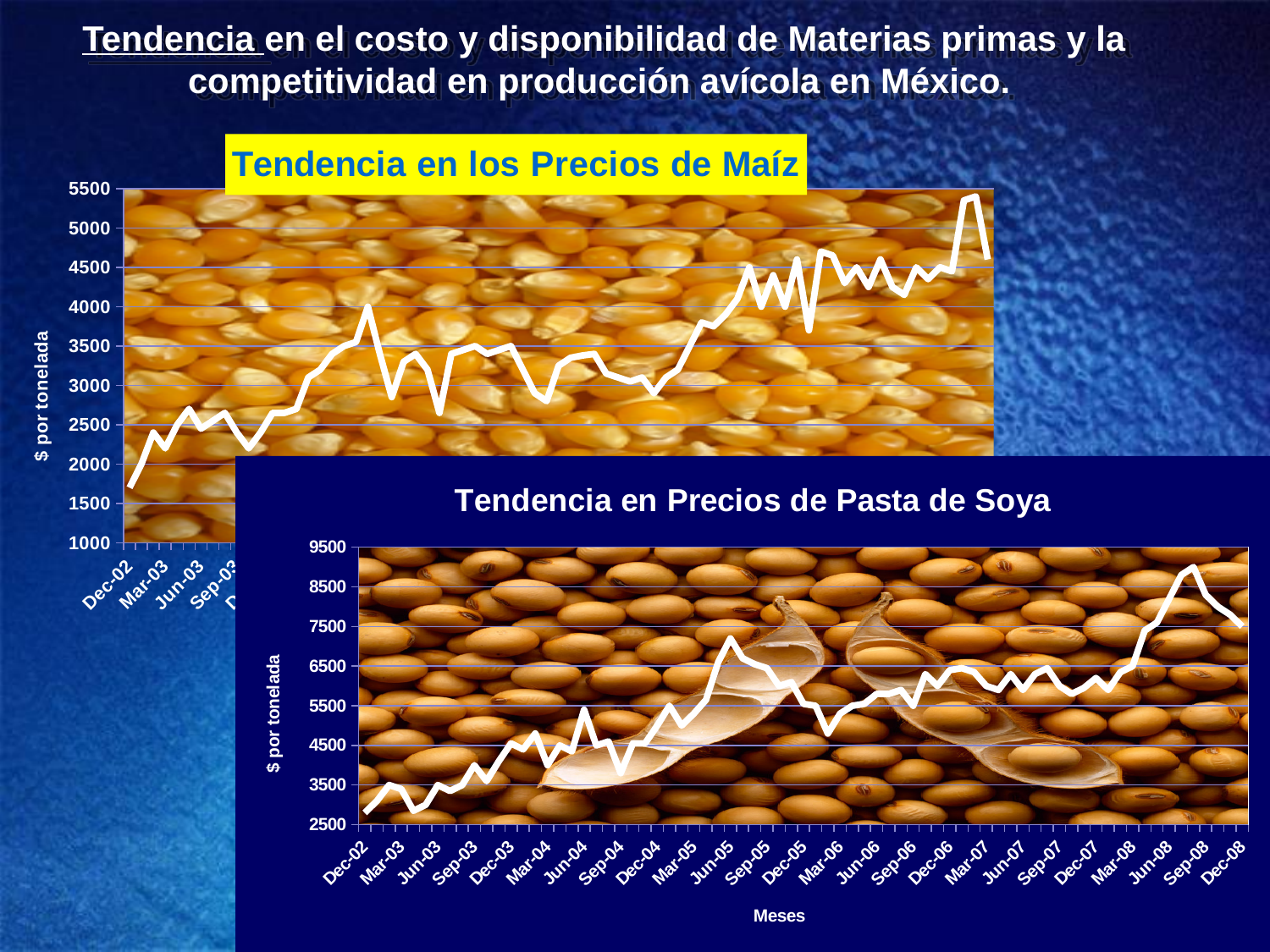
What type of chart is 'Tendencia en Precios de Pasta de Soya'? Line chart In the 'Tendencia en los Precios de Maíz' chart, is the highest peak of the line greater or less than 5000? greater In the 'Tendencia en Precios de Pasta de Soya' chart, is the value at Dec-08 larger or smaller than the value at Dec-02? larger In the 'Tendencia en los Precios de Maíz' chart, is the value at Dec-02 greater or less than 2000? less In the 'Tendencia en Precios de Pasta de Soya' chart, is the value at Dec-02 greater or less than 3500? less In the 'Tendencia en Precios de Pasta de Soya' chart, around which month does the line reach its lowest point? Dec-02 In the 'Tendencia en Precios de Pasta de Soya' chart, do soybean meal prices generally rise or fall from Dec-02 to Dec-08? Rise What is the x-axis label of the 'Tendencia en Precios de Pasta de Soya' chart? Meses What is the y-axis label of the 'Tendencia en Precios de Pasta de Soya' chart? $ por tonelada What type of chart is 'Tendencia en los Precios de Maíz'? Line chart In the 'Tendencia en los Precios de Maíz' chart, do corn prices generally rise or fall from Dec-02 to the end of the series? Rise